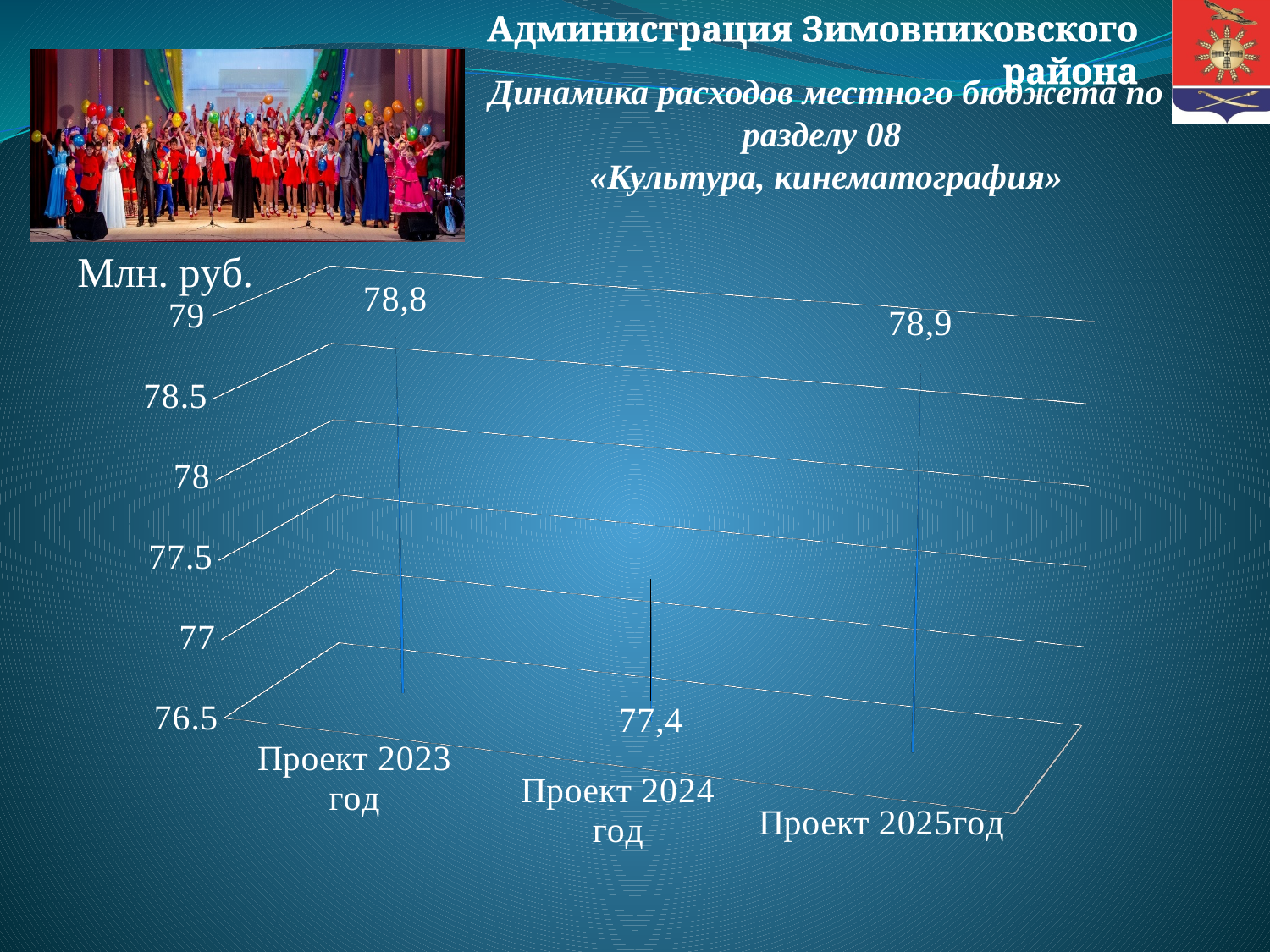
Is the value for Проект 2024 год greater or less than 78? less What is the value for Проект 2024 год? 77,4 What is the difference between the values for Проект 2025 год and Проект 2024 год? 1,5 What is the value for Проект 2025 год? 78,9 Which category has the highest value? Проект 2025 год How many categories are shown on the chart? 3 Which category has the lowest value? Проект 2024 год What is the value for Проект 2023 год? 78,8 What is the difference between the values for Проект 2023 год and Проект 2024 год? 1,4 Which is larger, the value for Проект 2023 год or Проект 2024 год? Проект 2023 год What kind of chart is shown on the slide? bar chart What unit is shown on the vertical axis of the chart? Млн. руб.